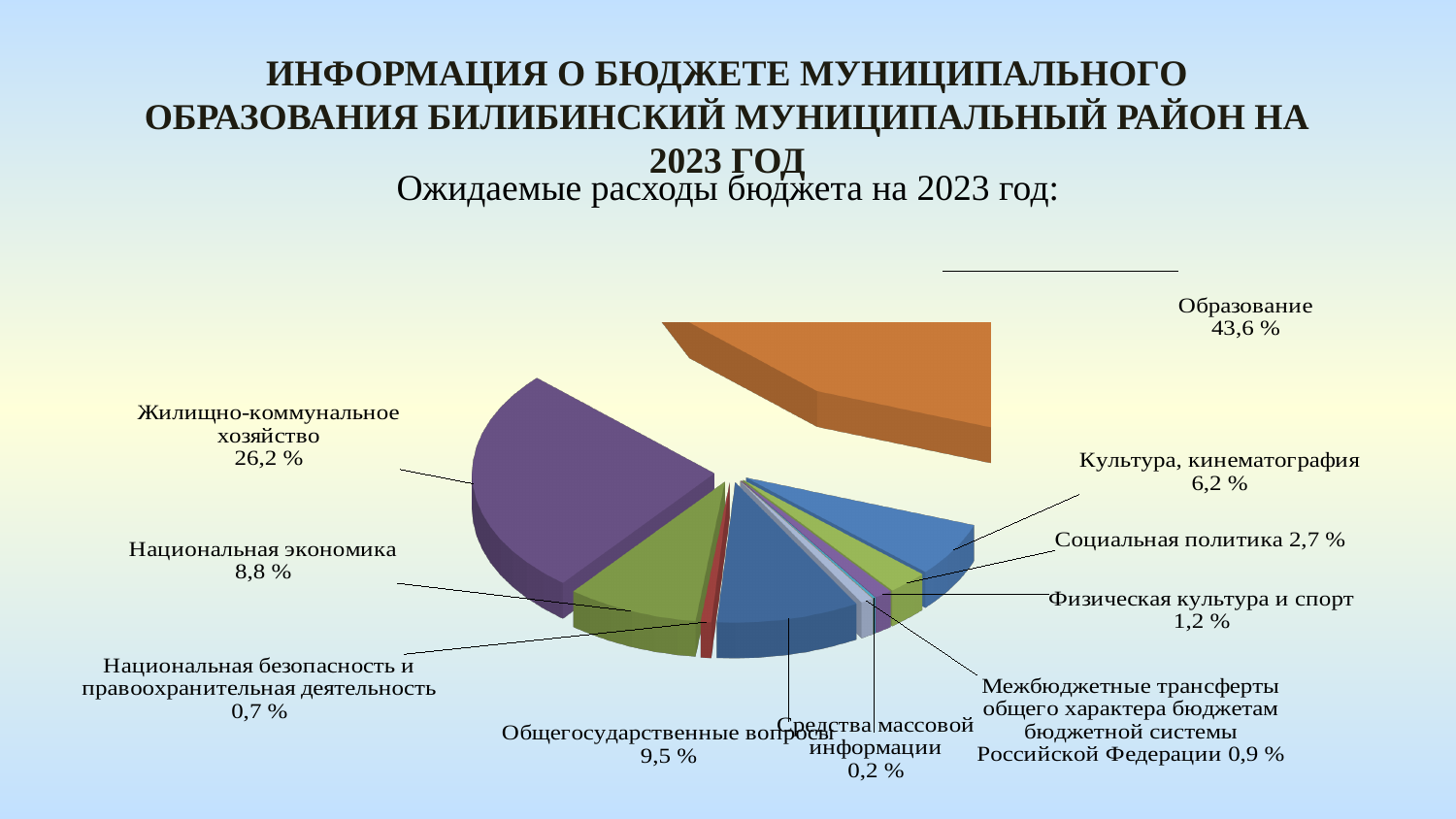
What kind of chart is shown on the slide? pie chart What is the difference in percentage points between the shares for Образование and Жилищно-коммунальное хозяйство? 17,4 What share is shown for Средства массовой информации? 0,2 % What share is shown for Общегосударственные вопросы? 9,5 % How many categories are shown in the pie chart? 10 What share of expected 2023 budget expenditures goes to Жилищно-коммунальное хозяйство? 26,2 % What share is shown for Культура, кинематография? 6,2 % What share of expected 2023 budget expenditures goes to Образование? 43,6 % Which is larger: the share for Национальная экономика or the share for Общегосударственные вопросы? Общегосударственные вопросы Which category has the smallest share of expected 2023 budget expenditures? Средства массовой информации Which category has the largest share of expected 2023 budget expenditures? Образование What is the subtitle of the chart on the slide? Ожидаемые расходы бюджета на 2023 год: